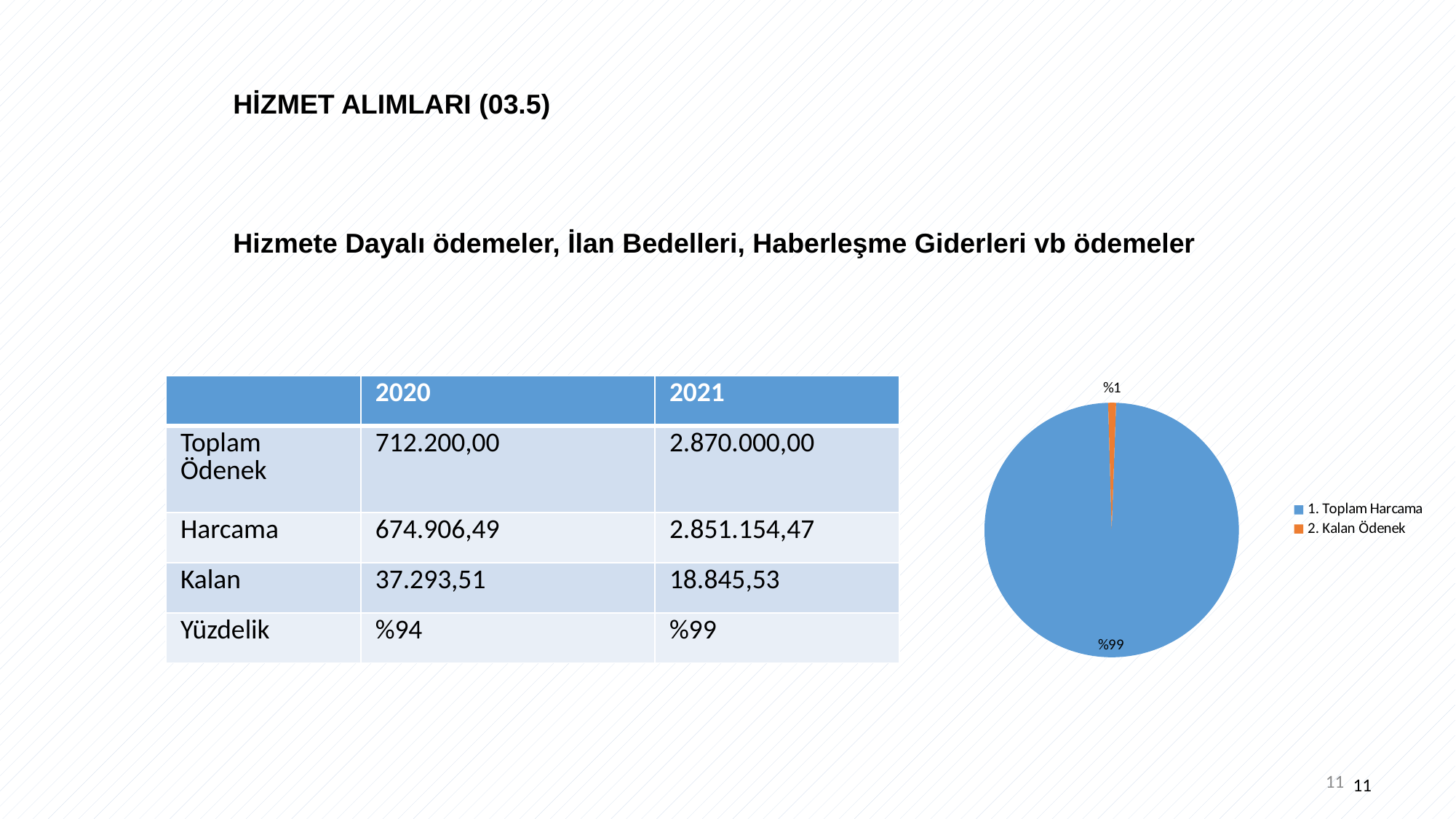
Which slice of the pie chart is the largest? 1. Toplam Harcama What share of the pie chart does '1. Toplam Harcama' take up? %99 What kind of chart is shown on the right side of the slide? pie chart How many slices does the pie chart have? 2 What percentage is shown for '1. Toplam Harcama' in the pie chart? %99 What colour is the '1. Toplam Harcama' slice in the pie chart? blue How many entries does the pie chart's legend list? 2 Which slice of the pie chart is the smallest? 2. Kalan Ödenek In the pie chart, which is larger: '1. Toplam Harcama' or '2. Kalan Ödenek'? 1. Toplam Harcama By how many percentage points does '1. Toplam Harcama' exceed '2. Kalan Ödenek' in the pie chart? 98 percentage points What percentage is shown for '2. Kalan Ödenek' in the pie chart? %1 What colour is the '2. Kalan Ödenek' slice in the pie chart? orange